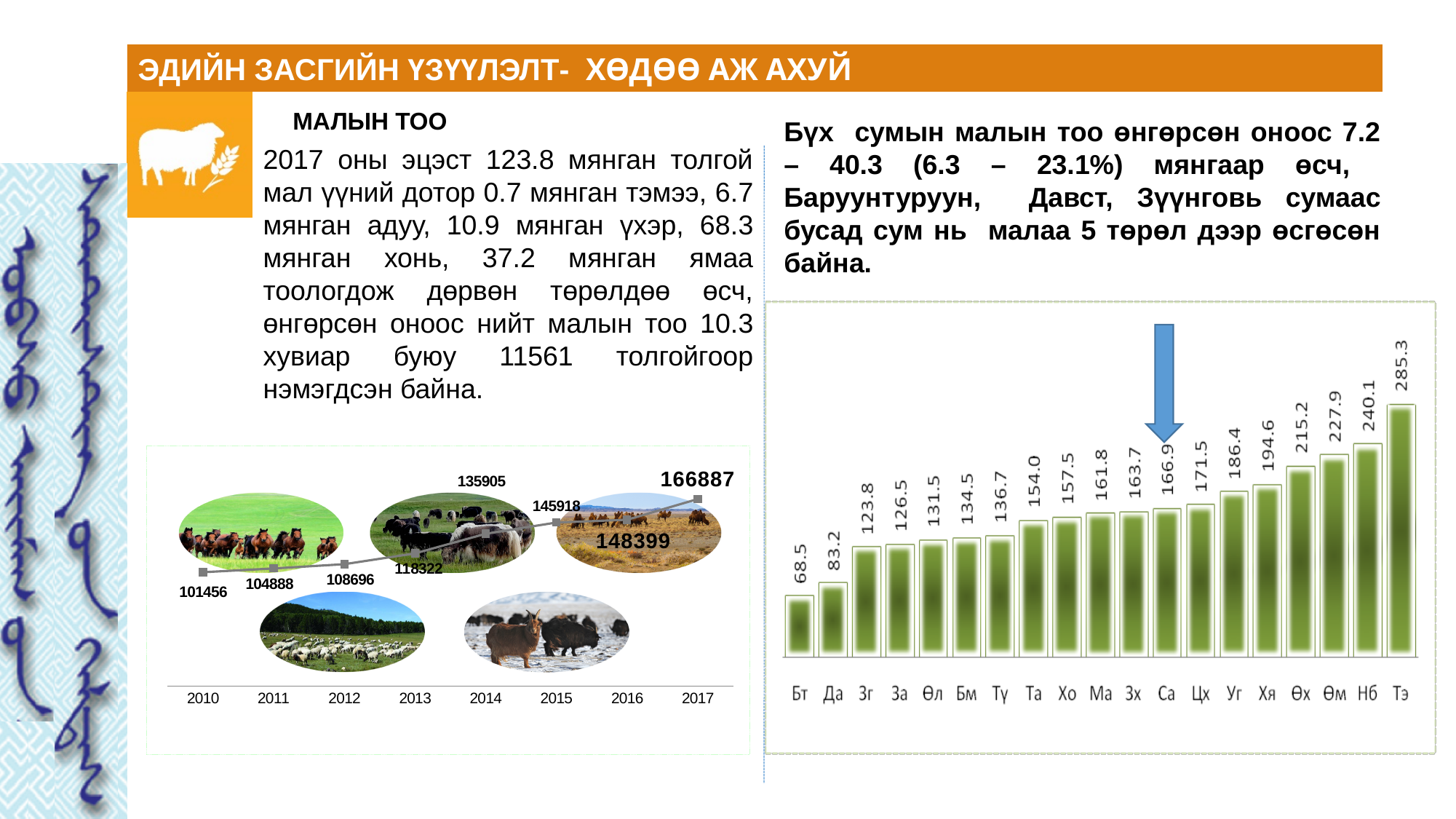
In the line chart on the left, what is the value for 2010? 101456 In the bar chart on the right, what is the value for Тэ? 285.3 In the bar chart on the right, which category has the lowest value? Бт In the bar chart on the right, what is the value for Са? 166.9 In the bar chart on the right, which is larger, the value for Уг or the value for Цх? Уг In the bar chart on the right, which category has the highest value? Тэ In the bar chart on the right, what is the value for Бт? 68.5 In the line chart on the left, what is the value for 2017? 166887 How many categories are shown in the bar chart on the right? 19 How many years are shown on the x axis of the line chart on the left? 8 What kind of chart is the chart on the right? bar chart In the bar chart on the right, what is the difference between the values for Нб and Өм? 12.2